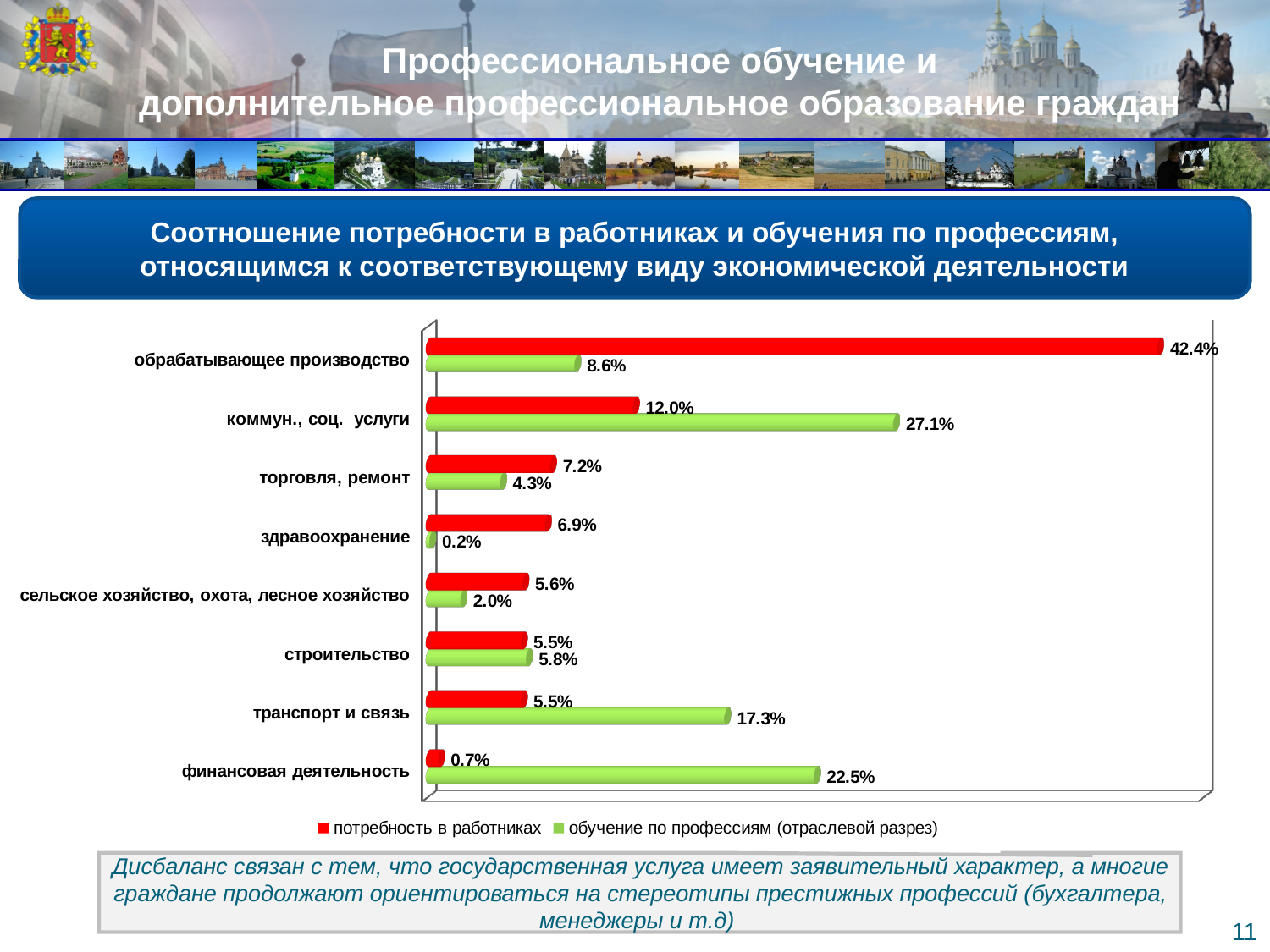
Which category has the highest value for "потребность в работниках"? обрабатывающее производство What is the value of "потребность в работниках" for "обрабатывающее производство"? 42.4% How many series does the legend list? 2 How many categories (types of economic activity) are shown on the chart? 8 What type of chart is shown on the slide? bar chart What is the difference between "потребность в работниках" and "обучение по профессиям (отраслевой разрез)" for "обрабатывающее производство"? 33.8% What is the value of "обучение по профессиям (отраслевой разрез)" for "финансовая деятельность"? 22.5% What is the value of "обучение по профессиям (отраслевой разрез)" for "здравоохранение"? 0.2% Which category has the lowest value for "обучение по профессиям (отраслевой разрез)"? здравоохранение What is the difference between "потребность в работниках" and "обучение по профессиям (отраслевой разрез)" for "коммун., соц. услуги"? 15.1% For "транспорт и связь", which is larger: "потребность в работниках" or "обучение по профессиям (отраслевой разрез)"? обучение по профессиям (отраслевой разрез) Which colour represents the series "потребность в работниках" in the legend? red